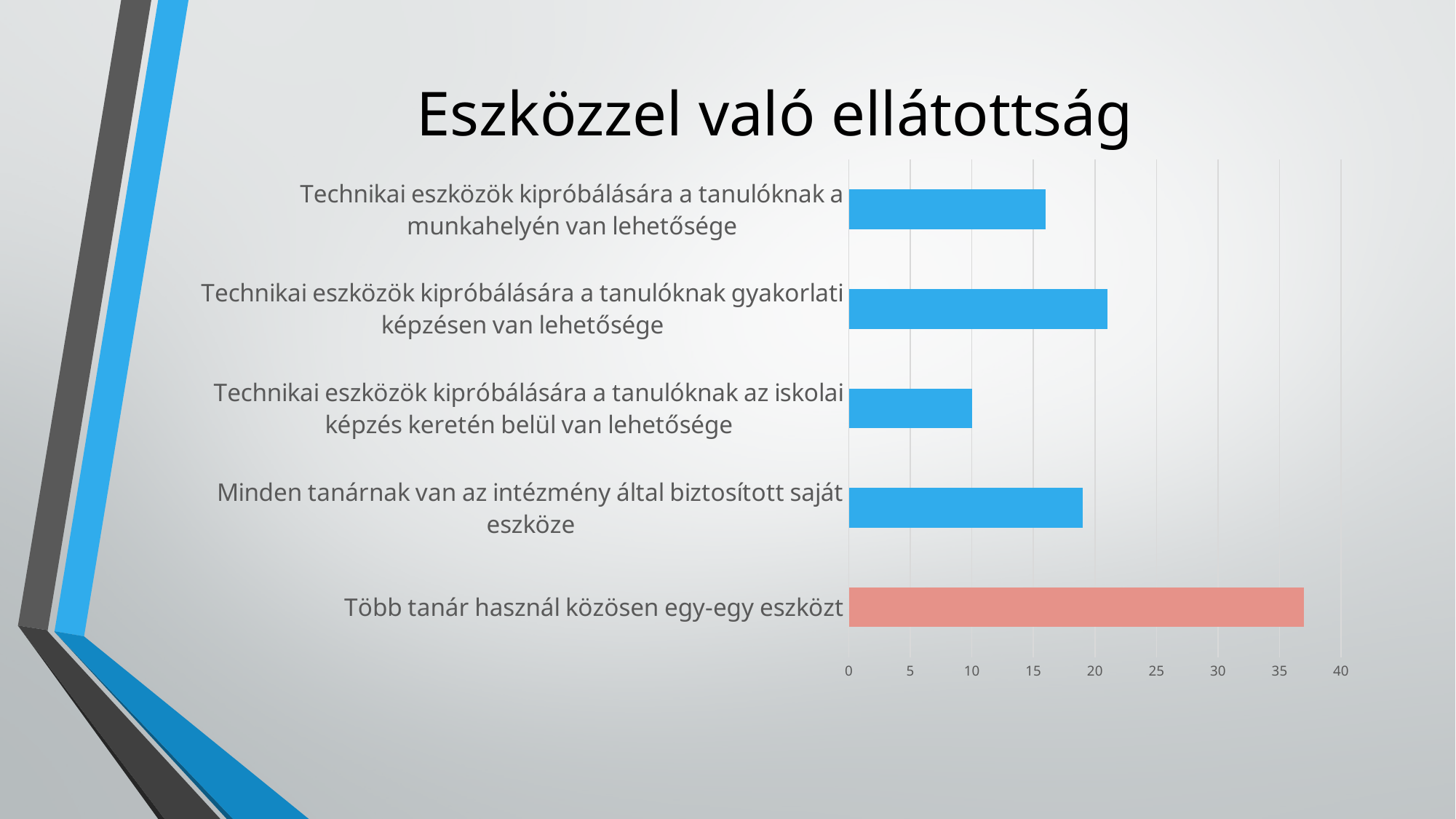
Is the value for 'Technikai eszközök kipróbálására a tanulóknak a munkahelyén van lehetősége' greater or less than 20? less Which category has the highest value? Több tanár használ közösen egy-egy eszközt Which is larger: the value for 'Technikai eszközök kipróbálására a tanulóknak gyakorlati képzésen van lehetősége' or for 'Technikai eszközök kipróbálására a tanulóknak a munkahelyén van lehetősége'? Technikai eszközök kipróbálására a tanulóknak gyakorlati képzésen van lehetősége What is the value for 'Technikai eszközök kipróbálására a tanulóknak az iskolai képzés keretén belül van lehetősége'? 10 What kind of chart is shown on the slide? bar chart Is the value for 'Több tanár használ közösen egy-egy eszközt' greater or less than 35? greater What is the title of the slide? Eszközzel való ellátottság Is the value for 'Technikai eszközök kipróbálására a tanulóknak gyakorlati képzésen van lehetősége' greater or less than 25? less How many categories are plotted in the chart? 5 What colour is the bar for 'Több tanár használ közösen egy-egy eszközt'? red (salmon) Which category has the lowest value? Technikai eszközök kipróbálására a tanulóknak az iskolai képzés keretén belül van lehetősége